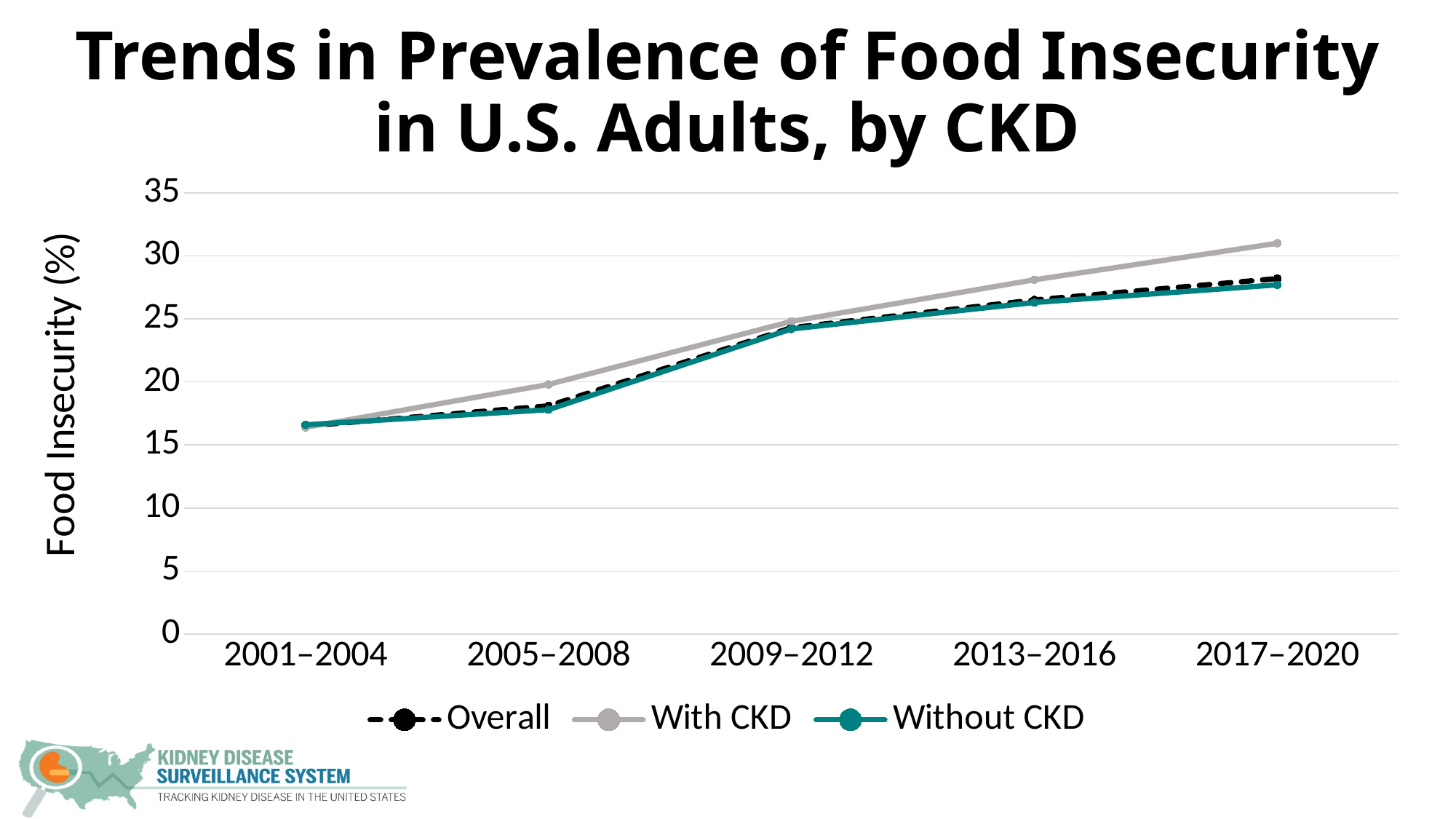
Is the value for With CKD in 2013–2016 greater or less than 25? greater In which period is the Overall value lowest? 2001–2004 In which period is the With CKD value highest? 2017–2020 Is the value for Overall in 2017–2020 greater or less than 25? greater In 2017–2020, which is larger: the value for With CKD or the value for Without CKD? With CKD How many time periods are shown on the x axis? 5 Do the values for With CKD rise or fall from 2001–2004 to 2017–2020? rise How many series does the legend list? 3 What is the label of the y axis? Food Insecurity (%) What kind of chart is shown on the slide? line chart Is the value for Without CKD in 2005–2008 greater or less than 20? less